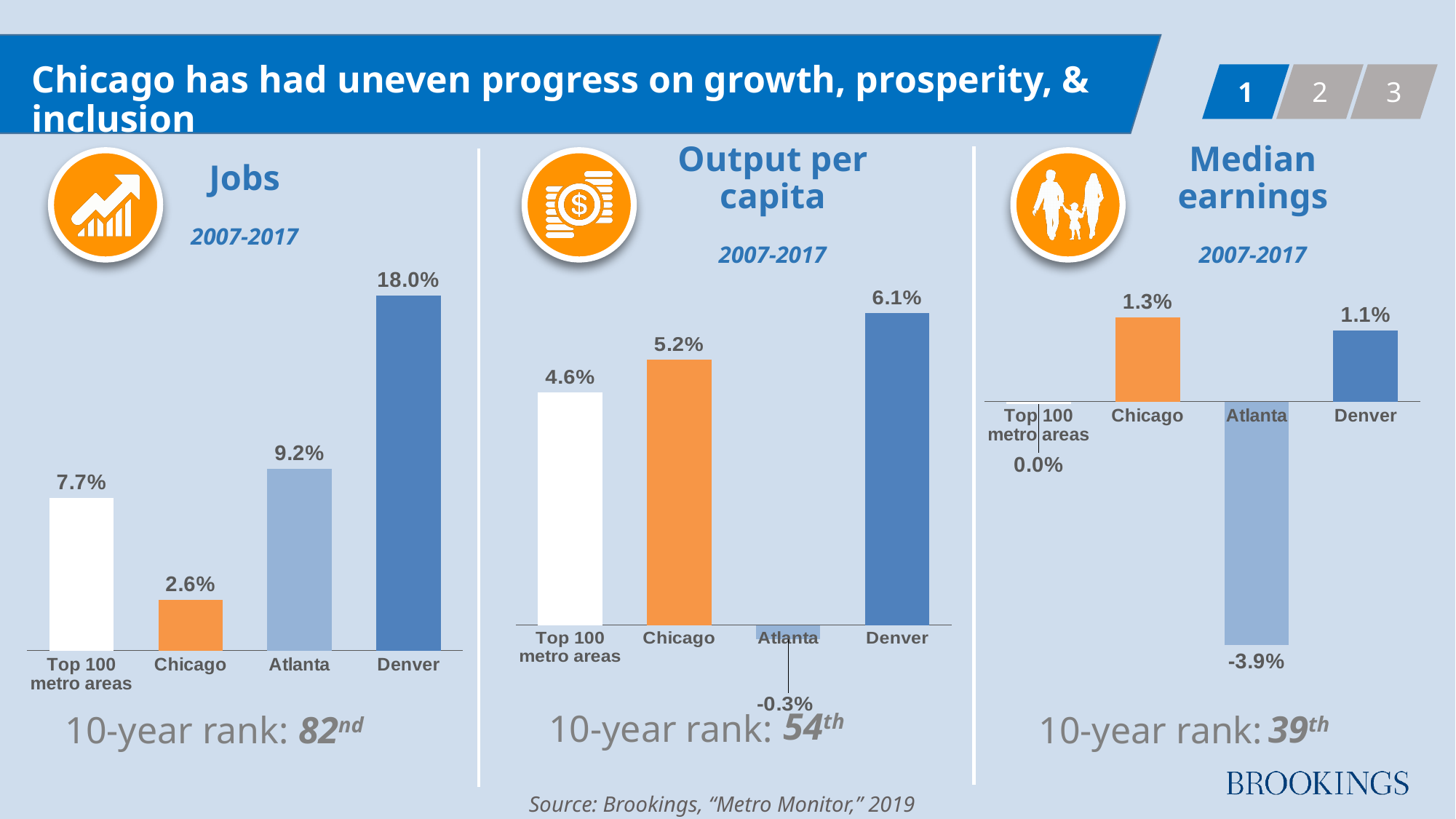
In the Jobs chart, what is the difference between Denver and Chicago? 15.4% In the Output per capita chart, what is the value for Atlanta? -0.3% How many categories does the Jobs chart show? 4 In the Median earnings chart, what is the value for Atlanta? -3.9% In the Output per capita chart, which category has the lowest value? Atlanta In the Jobs chart, what is the value for Chicago? 2.6% In the Median earnings chart, what is the difference between Chicago and Denver? 0.2% What kind of chart is the Output per capita chart? Bar chart What time period do the three charts cover? 2007-2017 In the Output per capita chart, which is larger, Chicago or Top 100 metro areas? Chicago In the Jobs chart, which category has the highest value? Denver In the Median earnings chart, which category has the highest value? Chicago